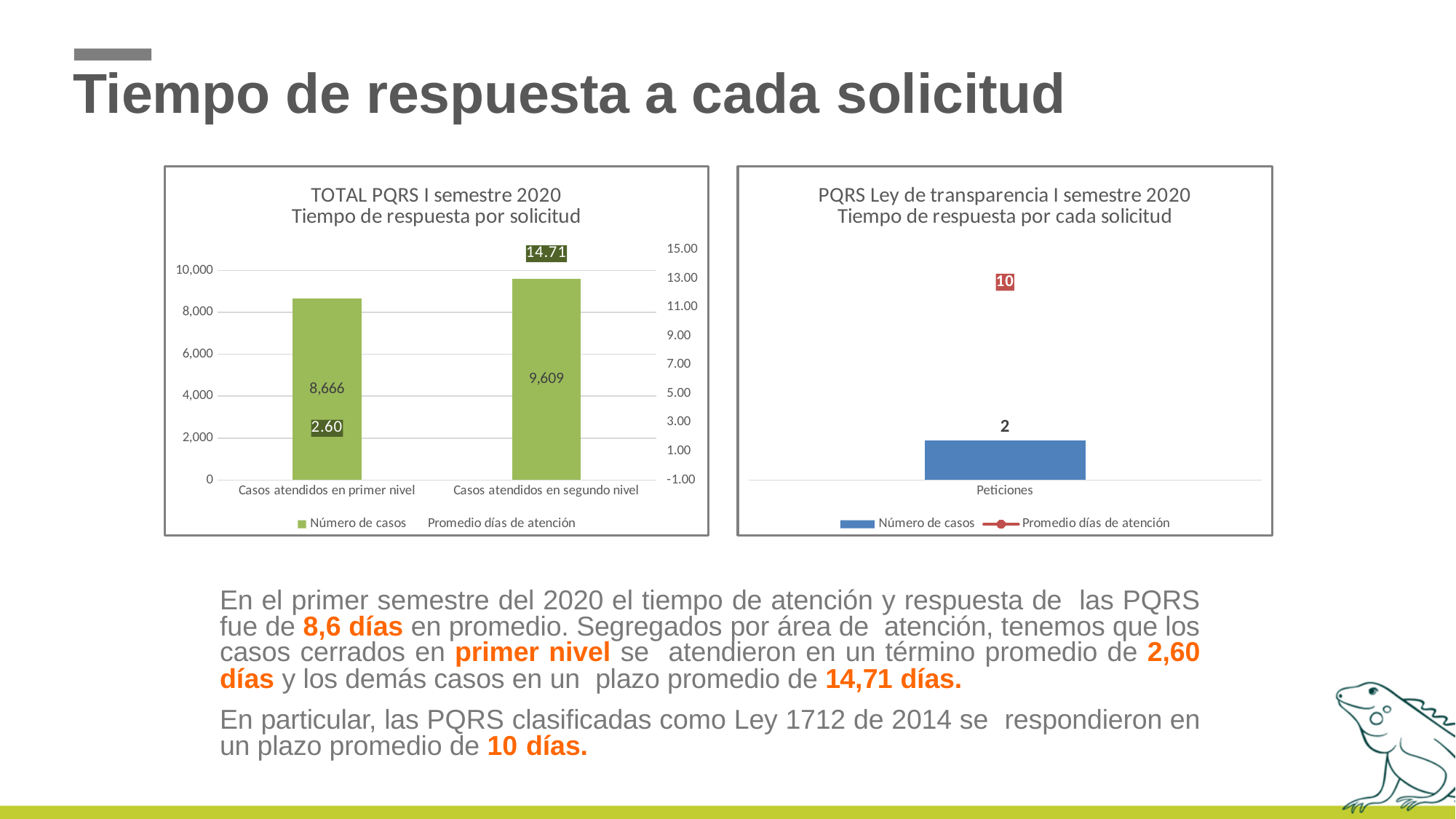
In the 'TOTAL PQRS I semestre 2020' chart, which category has the higher number of cases? Casos atendidos en segundo nivel In the 'PQRS Ley de transparencia I semestre 2020' chart, what is the number of cases for 'Peticiones'? 2 In the 'TOTAL PQRS I semestre 2020' chart, how many categories are shown on the x axis? 2 In the 'PQRS Ley de transparencia I semestre 2020' chart, what is the 'Promedio días de atención' value for 'Peticiones'? 10 In the 'TOTAL PQRS I semestre 2020' chart, what is the 'Promedio días de atención' value for 'Casos atendidos en segundo nivel'? 14.71 In the 'TOTAL PQRS I semestre 2020' chart, what is the number of cases for 'Casos atendidos en primer nivel'? 8,666 In the 'TOTAL PQRS I semestre 2020' chart, what is the number of cases for 'Casos atendidos en segundo nivel'? 9,609 In the 'TOTAL PQRS I semestre 2020' chart, what is the difference in number of cases between 'Casos atendidos en segundo nivel' and 'Casos atendidos en primer nivel'? 943 In the 'PQRS Ley de transparencia I semestre 2020' chart, what colour is the 'Número de casos' bar? Blue What kind of chart is the 'TOTAL PQRS I semestre 2020' chart? Bar chart In the 'TOTAL PQRS I semestre 2020' chart, what is the 'Promedio días de atención' value for 'Casos atendidos en primer nivel'? 2.60 In the 'TOTAL PQRS I semestre 2020' chart, how many series does the legend list? 2